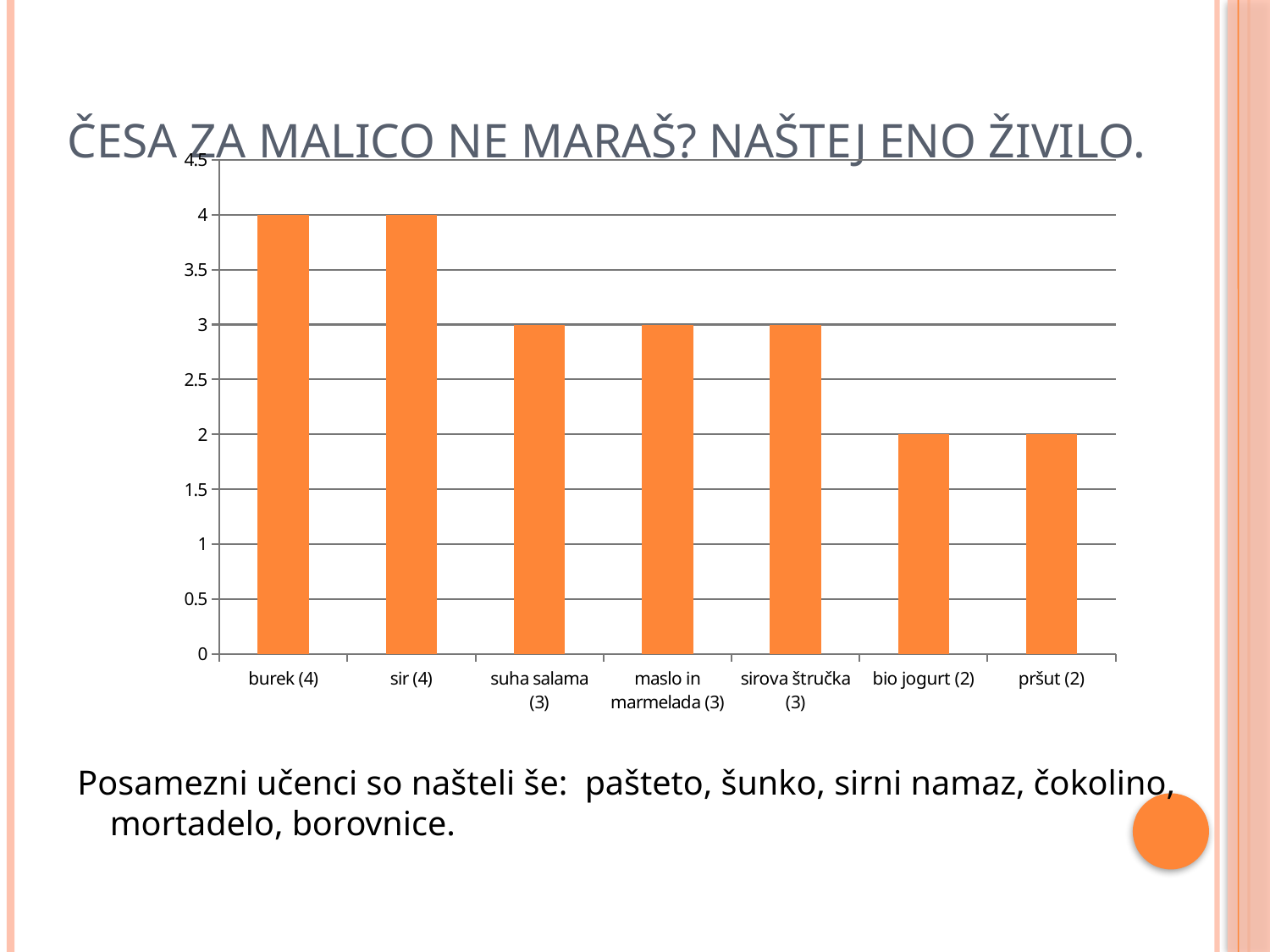
Is the value for suha salama greater or less than 3.5? less What is the value for maslo in marmelada? 3 What is the value for sirova štručka? 3 What is the value for pršut? 2 What kind of chart is shown on the slide? bar chart What is the difference between the values for burek and pršut? 2 What is the value for burek? 4 Which is larger, the value for sir or the value for bio jogurt? sir Which categories have the lowest value? bio jogurt and pršut Which categories have the highest value? burek and sir Do the values rise or fall from left to right along the x axis? fall How many categories are shown on the x axis? 7